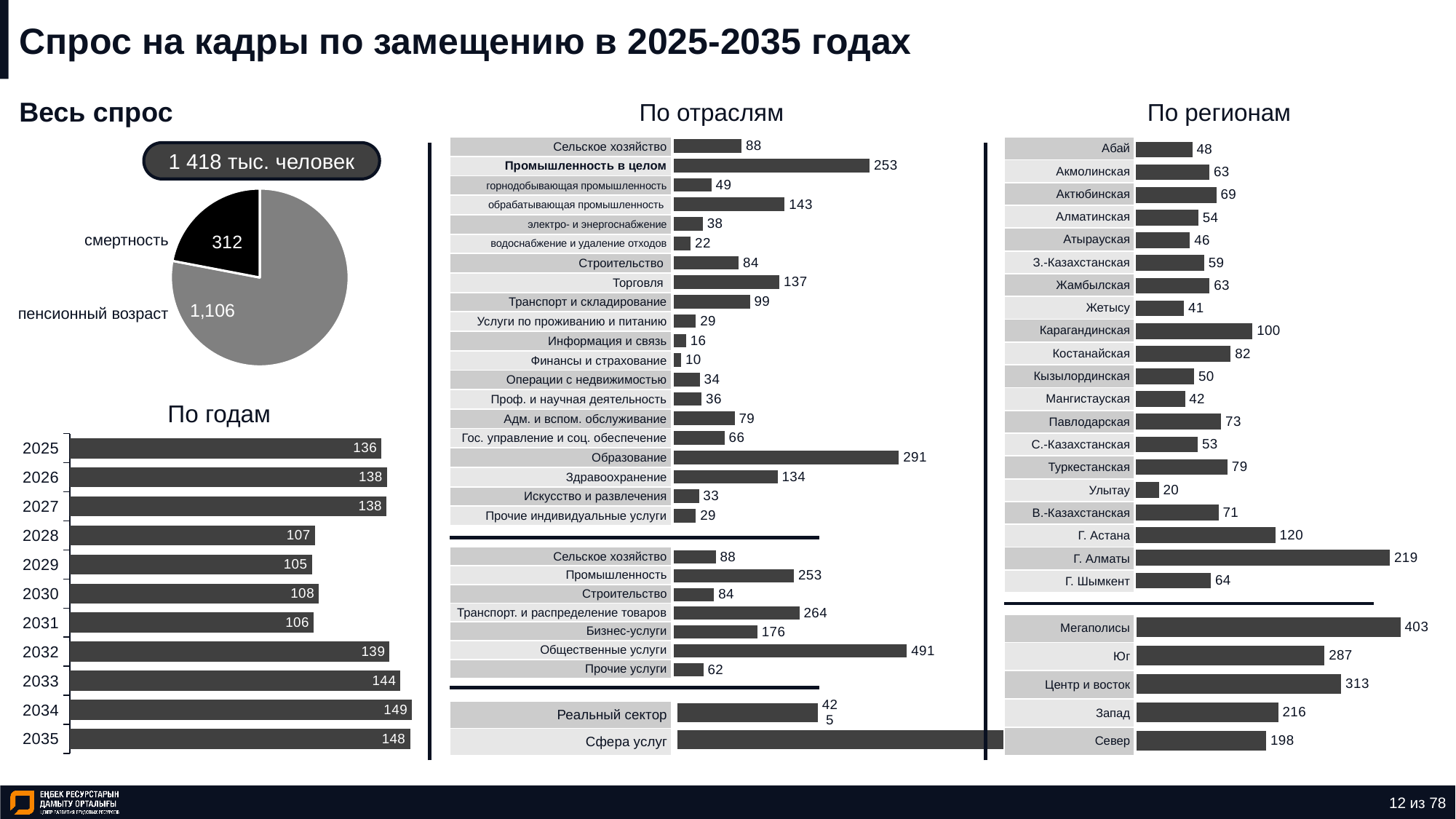
In the 'По годам' chart, what is the value for 2034? 149 In the top 'По регионам' chart, which region has the highest value? Г. Алматы In the top 'По отраслям' chart, what is the value for Торговля? 137 In the 'Весь спрос' pie chart, what is the value for смертность? 312 In the top 'По регионам' chart, what is the value for Карагандинская? 100 In the top 'По отраслям' chart, which category has the highest value? Образование In the bottom 'По регионам' chart, what is the difference between Мегаполисы and Север? 205 In the 'Весь спрос' pie chart, which slice is larger, смертность or пенсионный возраст? пенсионный возраст In the 'По годам' chart, how many years are plotted? 11 In the 'По годам' chart, which year has the lowest value? 2029 In the top 'По отраслям' chart, which category has the lowest value? Финансы и страхование In the 'По годам' chart, what is the difference between the values for 2035 and 2028? 41